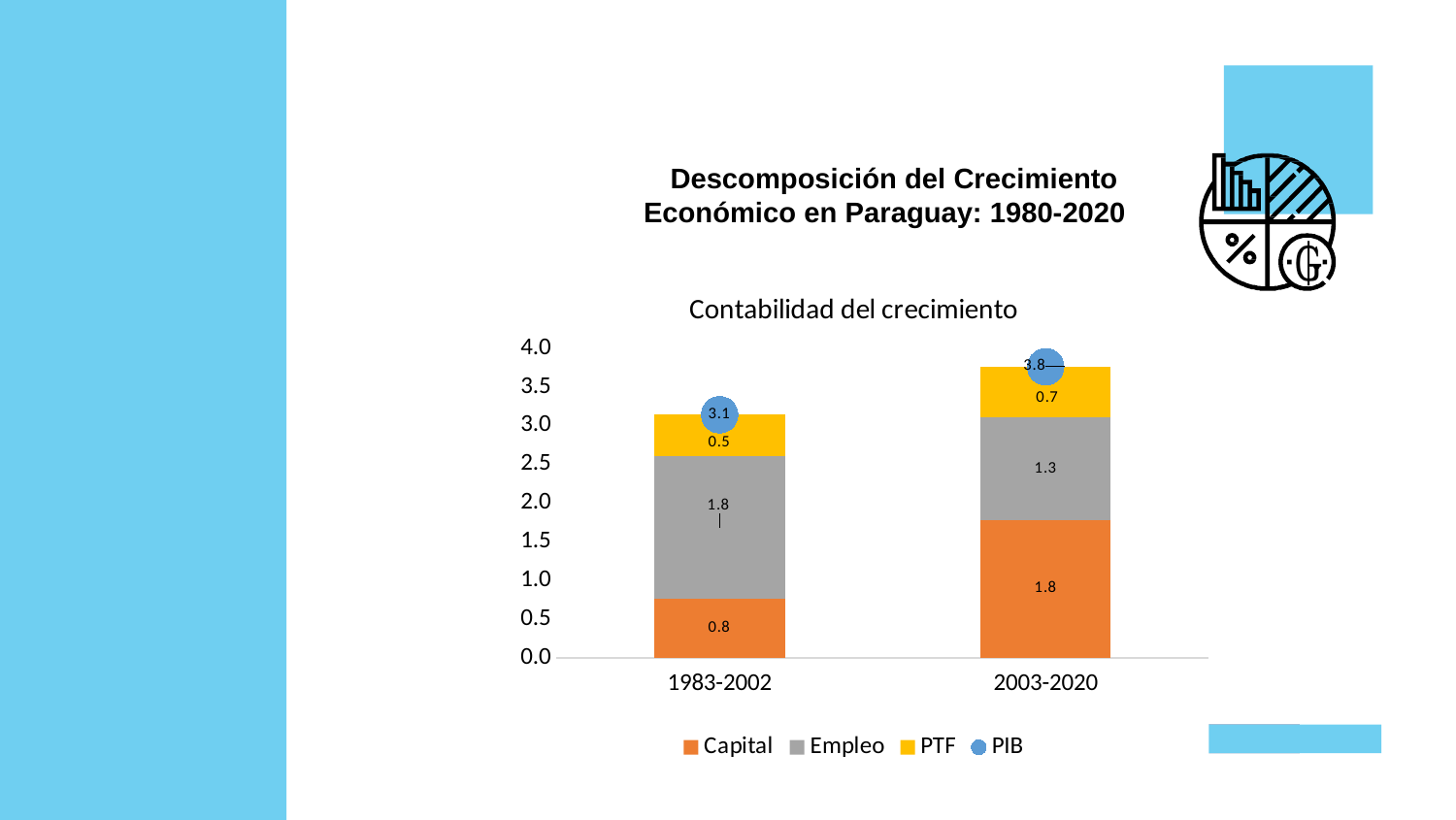
What type of chart is shown? Stacked bar chart What is the total of the stacked bar for 1983-2002 (Capital + Empleo + PTF)? 3.1 What is the difference between the Capital values for 2003-2020 and 1983-2002? 1.0 How many series does the legend list? 4 What is the Empleo value for 2003-2020? 1.3 How many periods are shown on the x axis? 2 What is the PIB value for 2003-2020? 3.8 What is the Capital value for 1983-2002? 0.8 Which period has the lower Empleo value? 2003-2020 What is the PTF value for 1983-2002? 0.5 Is the PTF value larger for 1983-2002 or for 2003-2020? 2003-2020 Which period has the higher PIB value? 2003-2020